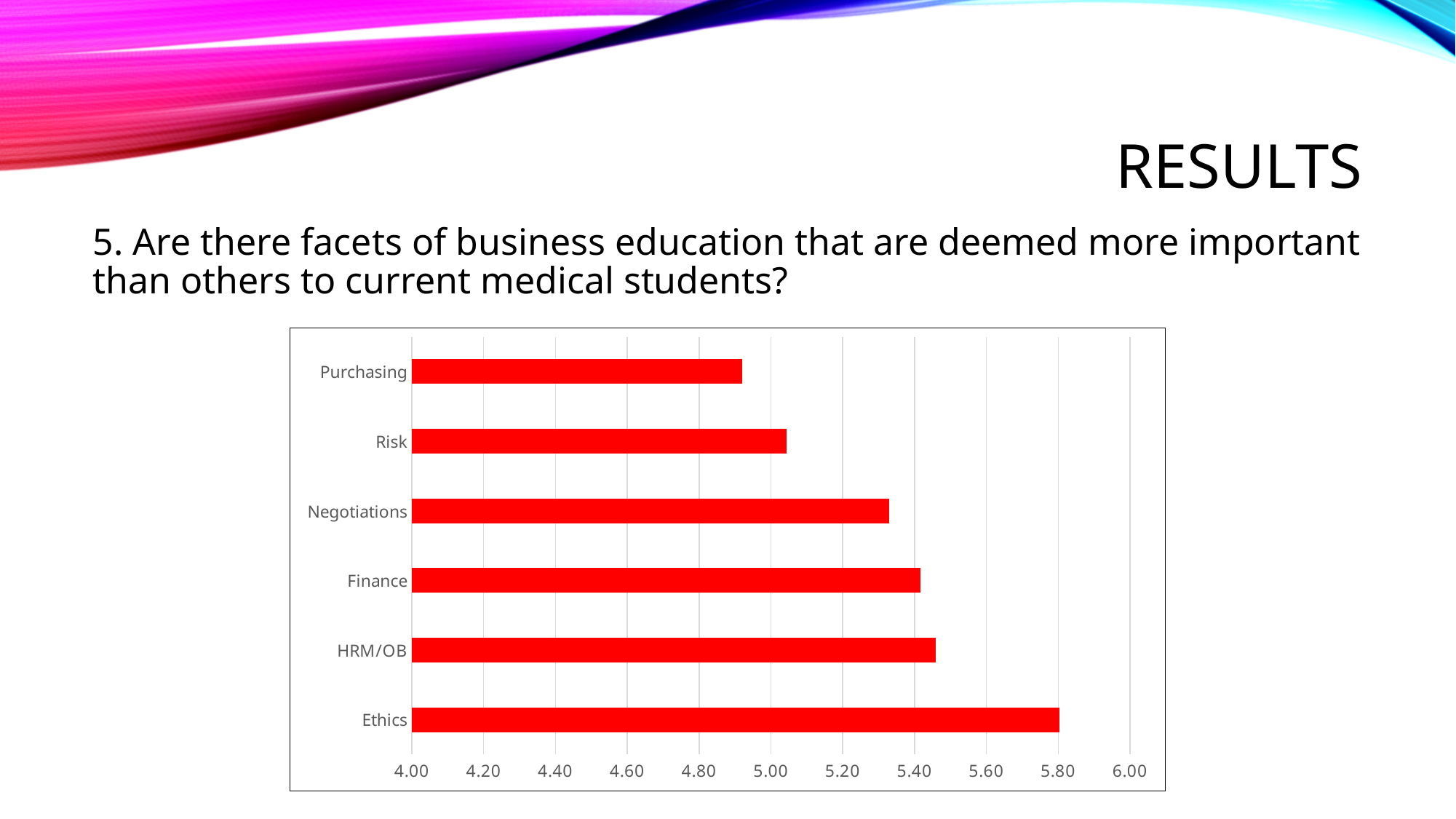
How many categories are plotted in the chart? 6 Which has a larger value, Negotiations or Risk? Negotiations Which category has the lowest value in the chart? Purchasing Is the value for HRM/OB greater or less than 5.40? greater Is the value for Ethics greater or less than 5.60? greater Which has a larger value, Ethics or Finance? Ethics Is the value for Purchasing greater or less than 5.00? less Which category has the highest value in the chart? Ethics What colour are the bars in the chart? red What type of chart is shown on the slide? bar chart